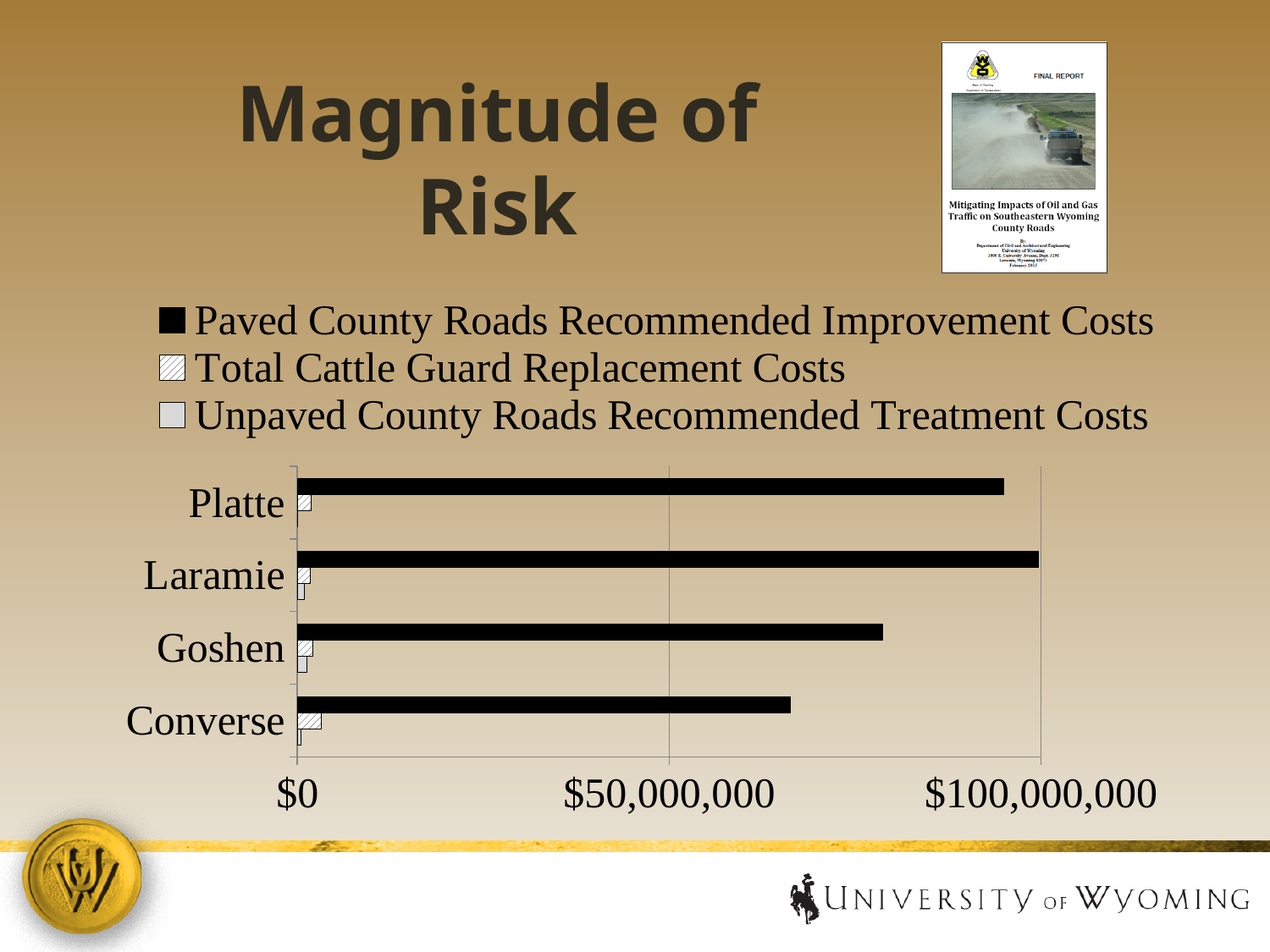
Is the Paved County Roads Recommended Improvement Costs value for Goshen greater or less than $100,000,000? less Which county has the highest Paved County Roads Recommended Improvement Costs? Laramie Which county has the largest Total Cattle Guard Replacement Costs bar? Converse Which county has the lowest Paved County Roads Recommended Improvement Costs? Converse Is the Total Cattle Guard Replacement Costs value for Converse greater or less than $50,000,000? less What kind of chart is shown on the slide? bar chart How many series does the legend list? 3 How many counties are shown on the chart? 4 What is the title of the slide containing the chart? Magnitude of Risk Which is larger, the Paved County Roads Recommended Improvement Costs for Goshen or for Converse? Goshen Which series is shown with solid black bars? Paved County Roads Recommended Improvement Costs Is the Paved County Roads Recommended Improvement Costs value for Platte greater or less than $50,000,000? greater